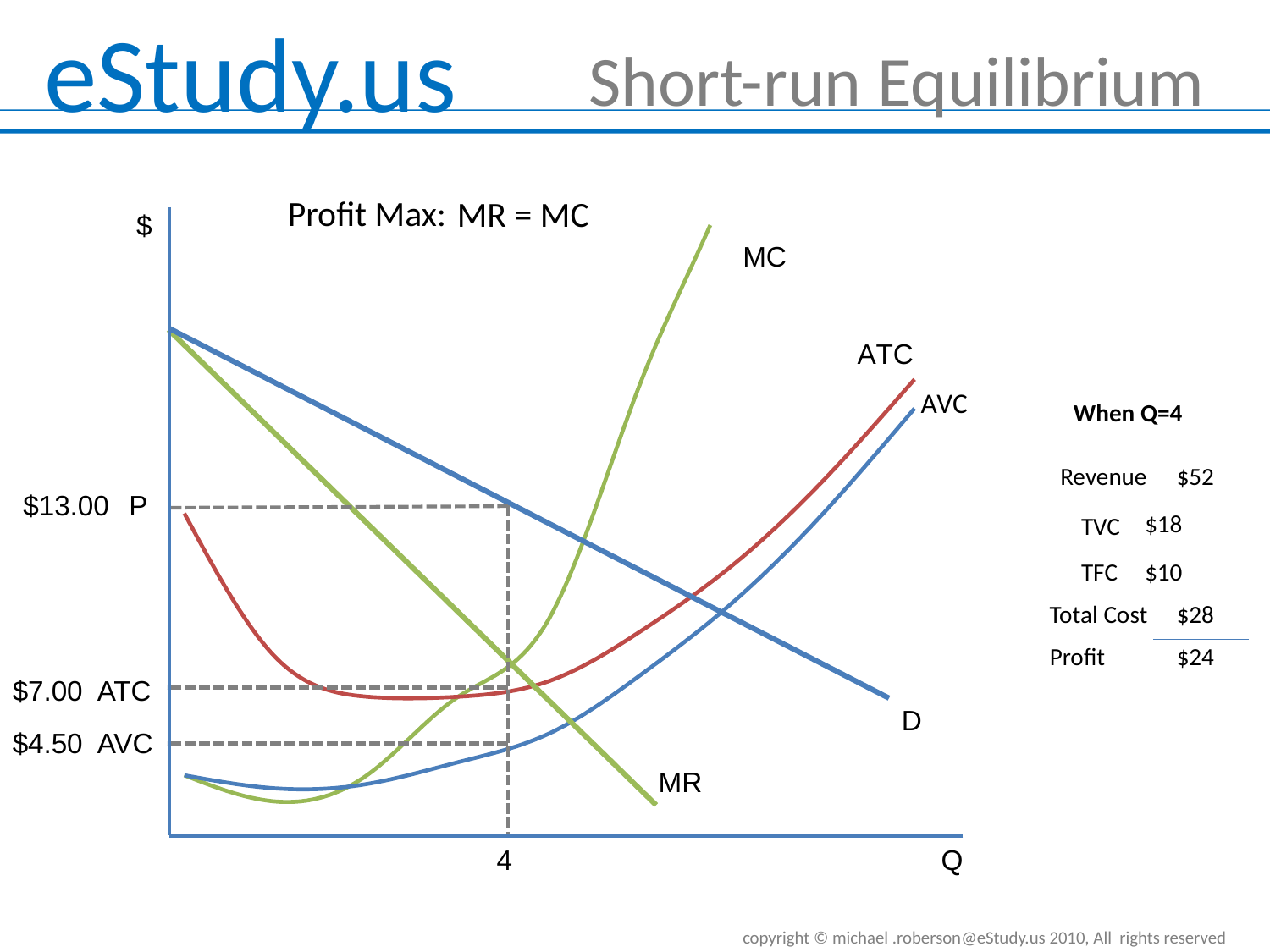
How many labelled curves are drawn on the chart? 5 What is the value of ATC at Q=4 shown on the chart? $7.00 What is the value of AVC at Q=4 shown on the chart? $4.50 What is the title printed above the chart? Profit Max: MR = MC What label is on the horizontal axis of the chart? Q What is the price P at Q=4 according to the dashed line on the chart? $13.00 What kind of chart is shown on the slide? Line chart What is the difference between ATC and AVC at Q=4? $2.50 Does the demand curve D rise or fall as Q increases? Fall At Q=4, which is larger: ATC or AVC? ATC What is the difference between the price P and ATC at Q=4? $6.00 At Q=4, which is larger: the price P or ATC? P